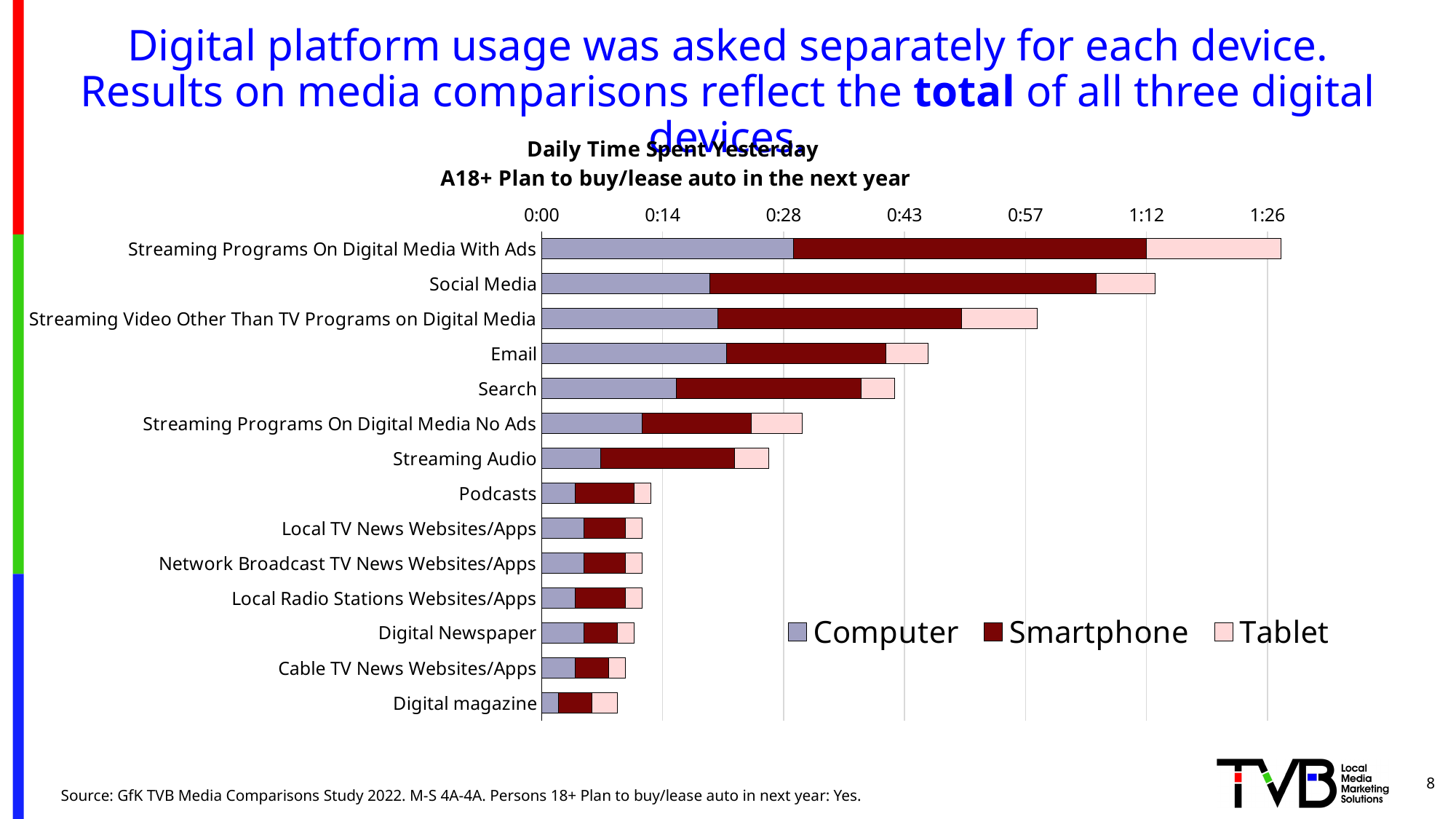
Which has a longer total bar, Social Media or Email? Social Media Is the total daily time for Social Media greater or less than 0:57? greater Is the total daily time for Streaming Video Other Than TV Programs on Digital Media greater or less than 0:43? greater Is the total daily time for Digital magazine greater or less than 0:14? less Which has a longer total bar, Streaming Audio or Podcasts? Streaming Audio Which category has the longest total bar? Streaming Programs On Digital Media With Ads What kind of chart is shown on the slide? Stacked bar chart How many series does the legend list? 3 Which series is shown in the darkest red colour in the legend? Smartphone How many categories (media types) are listed on the chart? 14 Which category has the shortest total bar? Digital magazine